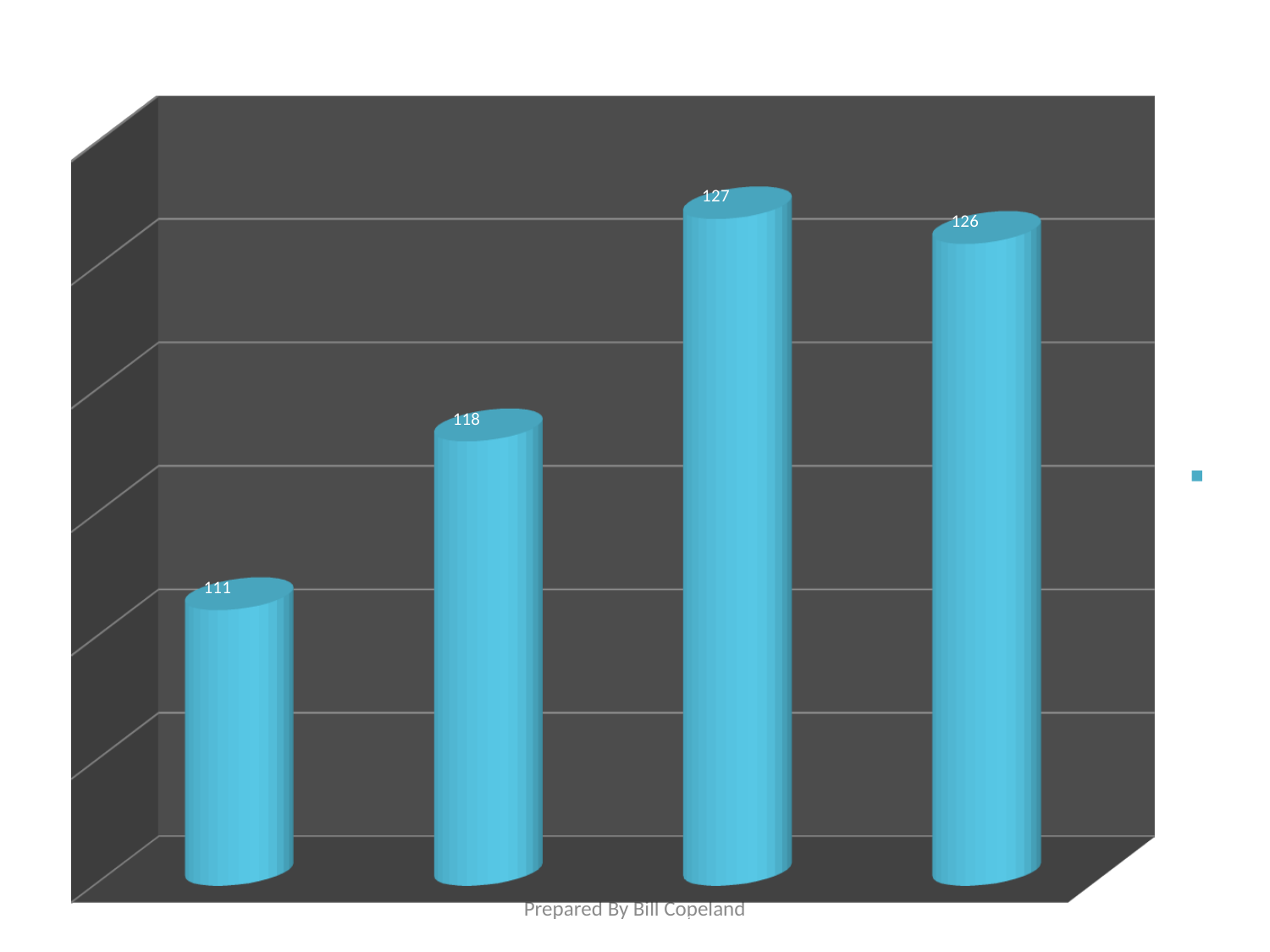
What kind of chart is shown on the slide? bar chart What is the value shown on the fourth (rightmost) bar? 126 What is the value shown on the first (leftmost) bar? 111 What is the difference between the values of the third bar and the first bar? 16 What text appears at the bottom of the chart? Prepared By Bill Copeland What is the value shown on the third bar from the left? 127 How many bars are plotted in the chart? 4 Which bar has the lowest value? the first bar (111) Which is larger, the value of the second bar or the value of the fourth bar? the fourth bar (126) Which bar has the highest value? the third bar (127) What is the value shown on the second bar from the left? 118 What is the difference between the values of the second bar and the first bar? 7